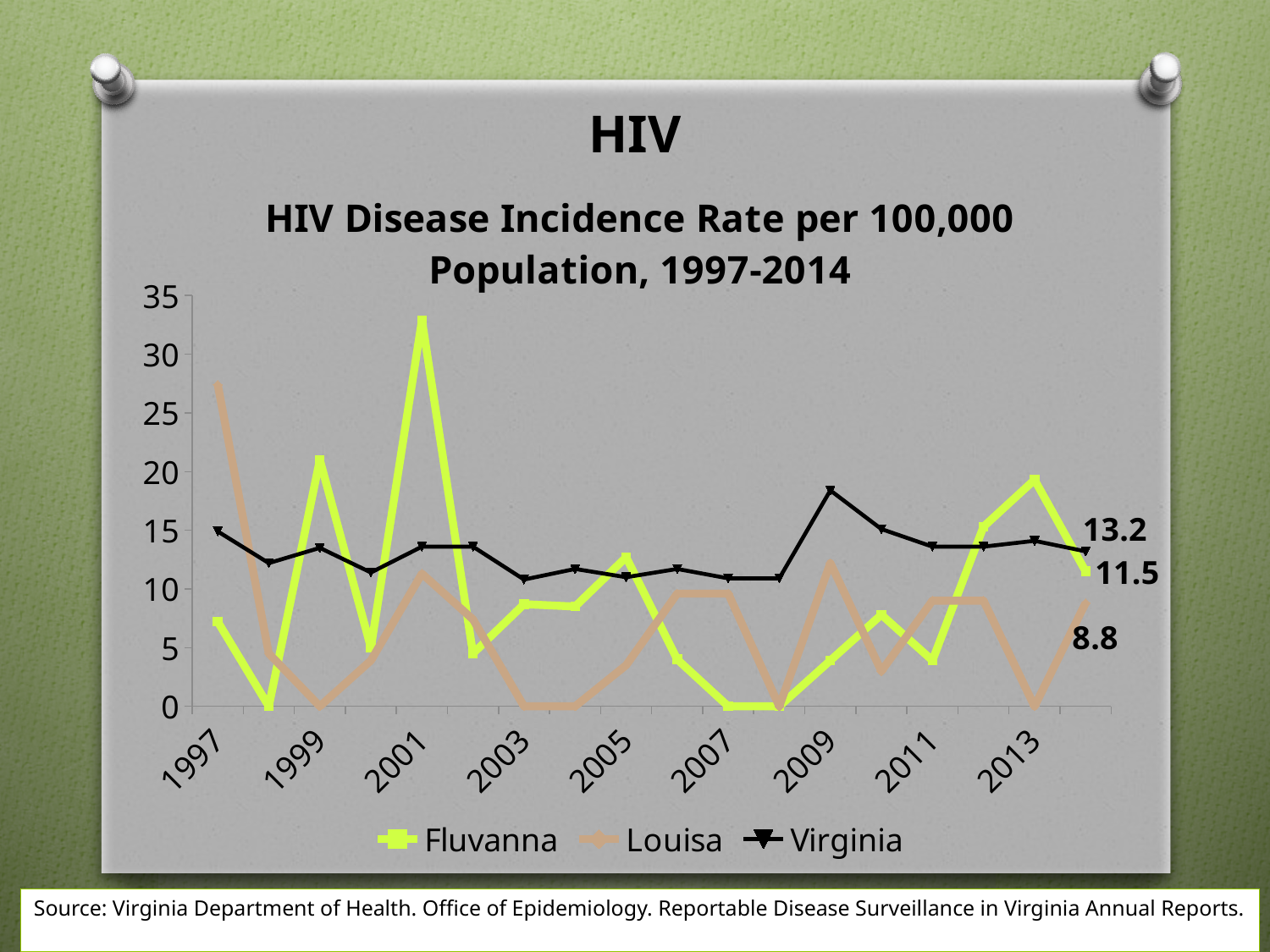
What is the difference between the Virginia and Fluvanna rates in 2014? 1.7 How many series does the legend list? 3 Which series has the highest value in 2014? Virginia What is the HIV disease incidence rate for Louisa in 2014? 8.8 What kind of chart is shown on the slide? line chart What is the title of the chart? HIV Disease Incidence Rate per 100,000 Population, 1997-2014 Is the value for Louisa in 1997 greater or less than 25? greater Which series has the lowest value in 2014? Louisa What is the HIV disease incidence rate for Virginia in 2014? 13.2 What is the difference between the Fluvanna and Louisa rates in 2014? 2.7 What is the HIV disease incidence rate for Fluvanna in 2014? 11.5 Is the value for Fluvanna in 2001 greater or less than 30? greater